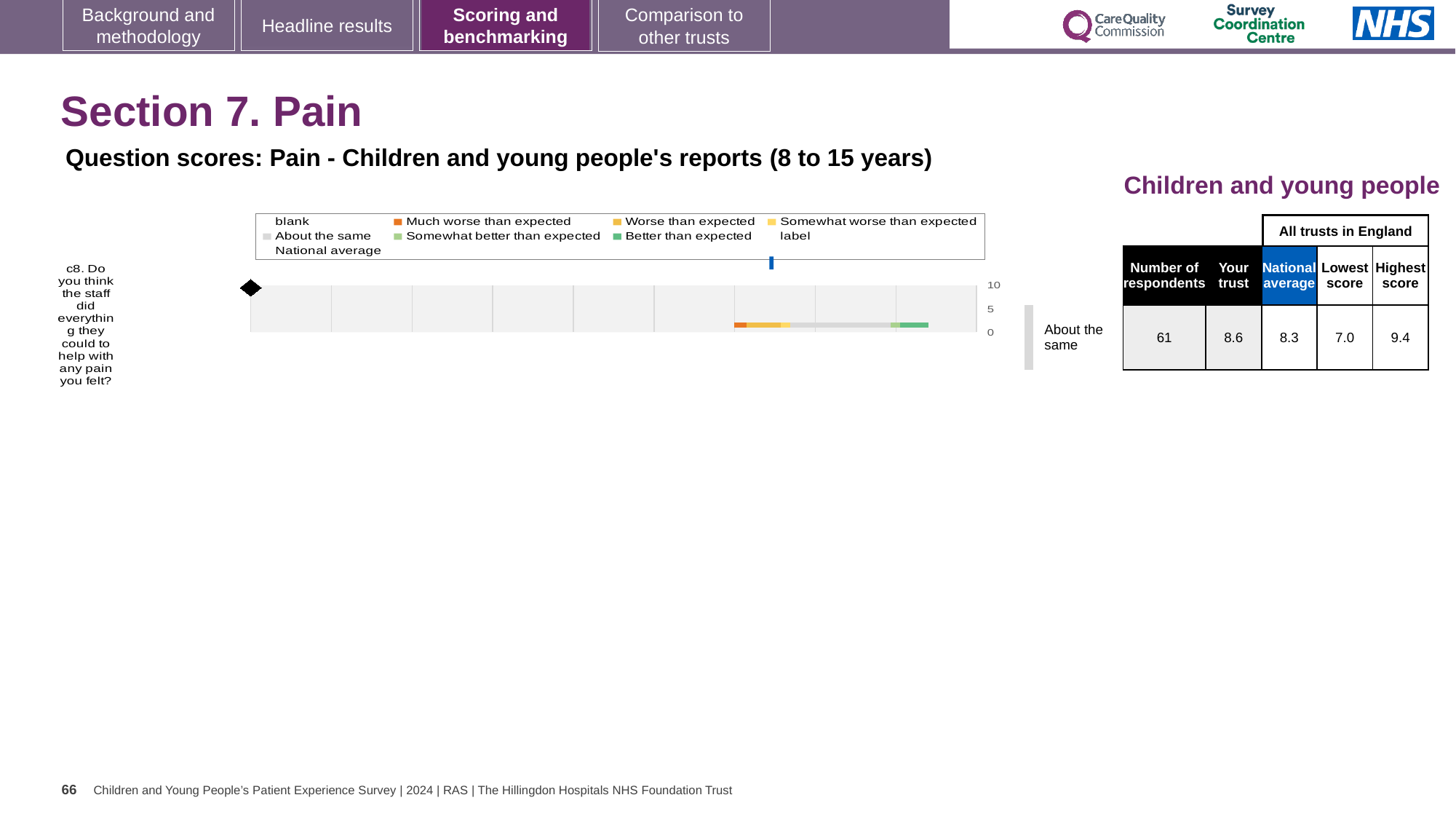
In the table beside the chart, what is the lowest score among all trusts in England for c8? 7.0 In the table beside the chart, what is the national average score for c8? 8.3 How many entries does the chart legend list? 9 What is the question label shown on the chart's category axis? c8. Do you think the staff did everything they could to help with any pain you felt? In the table beside the chart, what is the 'Your trust' score for c8? 8.6 What kind of chart is shown on the slide? bar chart What is the highest value shown on the chart's numeric axis? 10 In the table beside the chart, how many respondents answered c8? 61 How many questions (categories) are plotted on the chart? 1 In the table beside the chart, what is the highest score among all trusts in England for c8? 9.4 In the table beside the chart, which is larger for c8: the 'Your trust' score or the national average? Your trust According to the label beside the chart, which benchmark category does the trust's result for c8 fall into? About the same